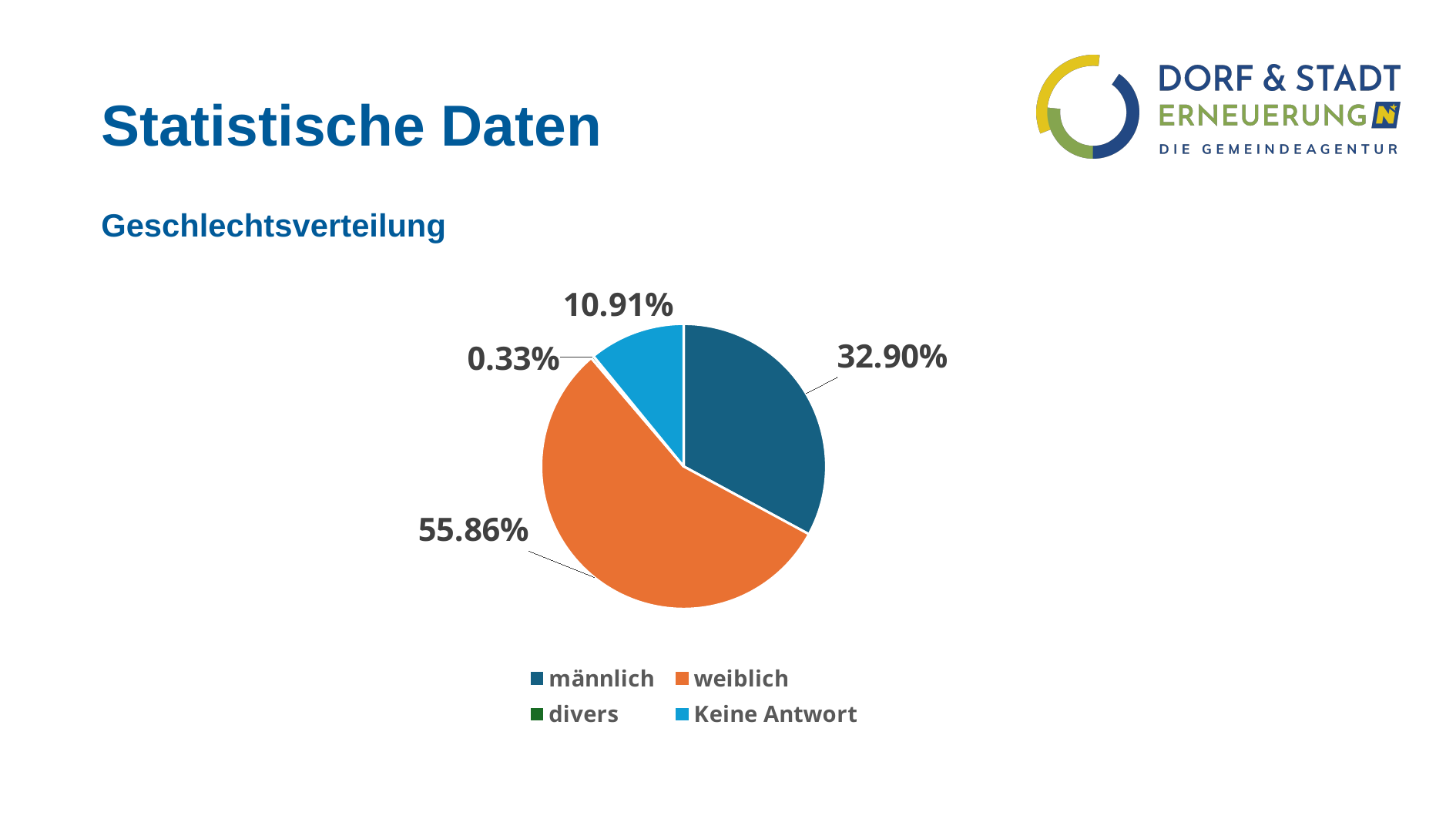
What share of the pie does weiblich have? 55.86% What is the difference in percentage points between männlich and Keine Antwort? 21.99 What is the title of the chart? Geschlechtsverteilung What kind of chart is shown on the slide? pie chart Which category has the smallest slice of the pie? divers Which category has the largest slice of the pie? weiblich What share of the pie does Keine Antwort have? 10.91% What share of the pie does männlich have? 32.90% What share of the pie does divers have? 0.33% How many categories does the pie chart show? 4 What is the difference in percentage points between weiblich and männlich? 22.96 Which is larger, the share for männlich or the share for Keine Antwort? männlich